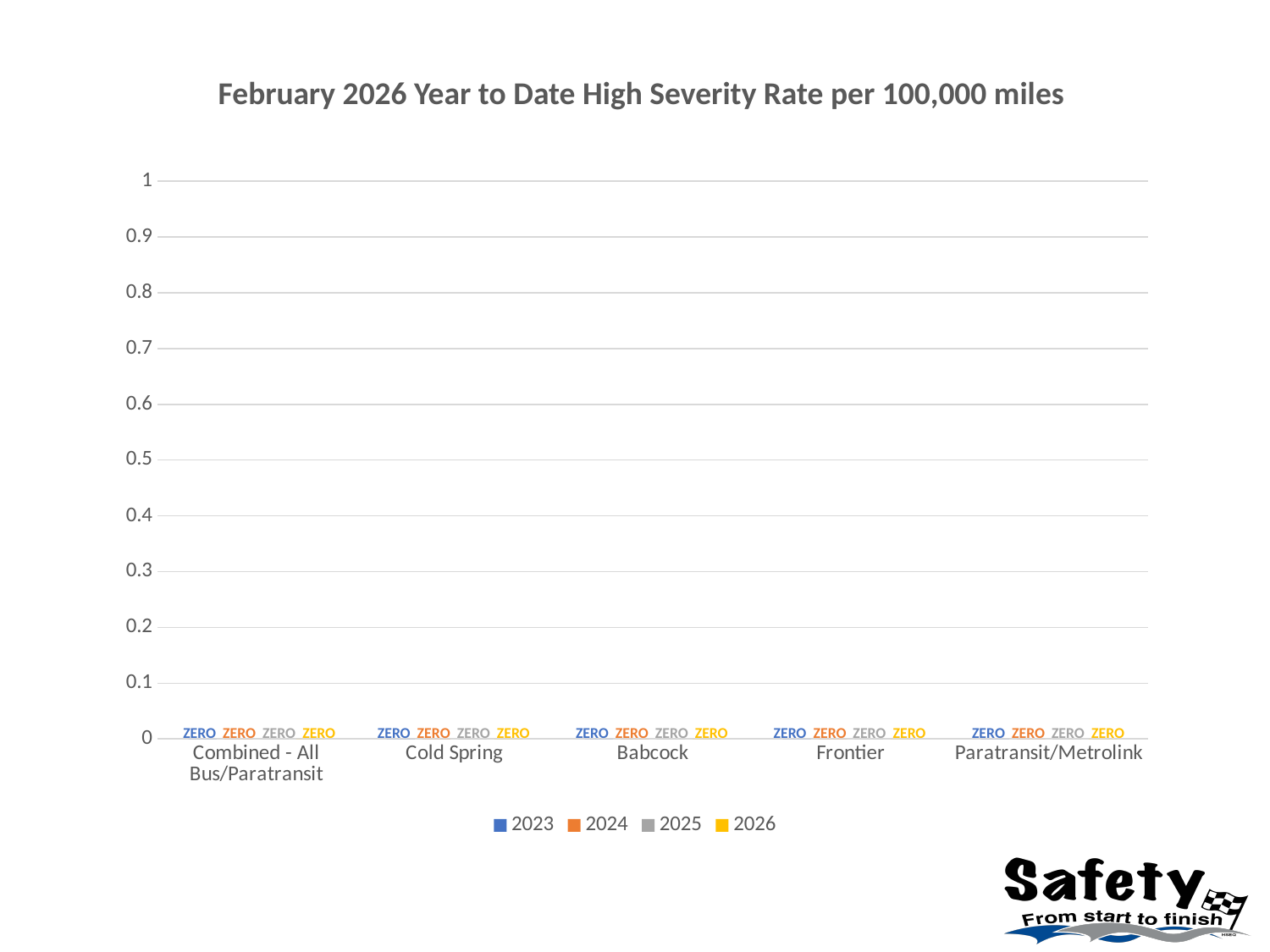
What is the data label shown for Cold Spring in 2026? ZERO What is the data label shown for Frontier in 2025? ZERO What is the data label shown for Babcock in 2023? ZERO Which years are listed in the chart's legend? 2023, 2024, 2025, 2026 How many categories are shown along the x axis of the chart? 5 What is the highest value shown on the vertical axis of the chart? 1 Is the value for Combined - All Bus/Paratransit in 2026 greater or less than 0.5? less What is the difference between the 2024 value for Frontier and the 2024 value for Babcock? 0 How many series does the legend list? 4 What is the title of the chart? February 2026 Year to Date High Severity Rate per 100,000 miles What is the data label shown for Paratransit/Metrolink in 2024? ZERO What kind of chart is shown on the slide? bar chart